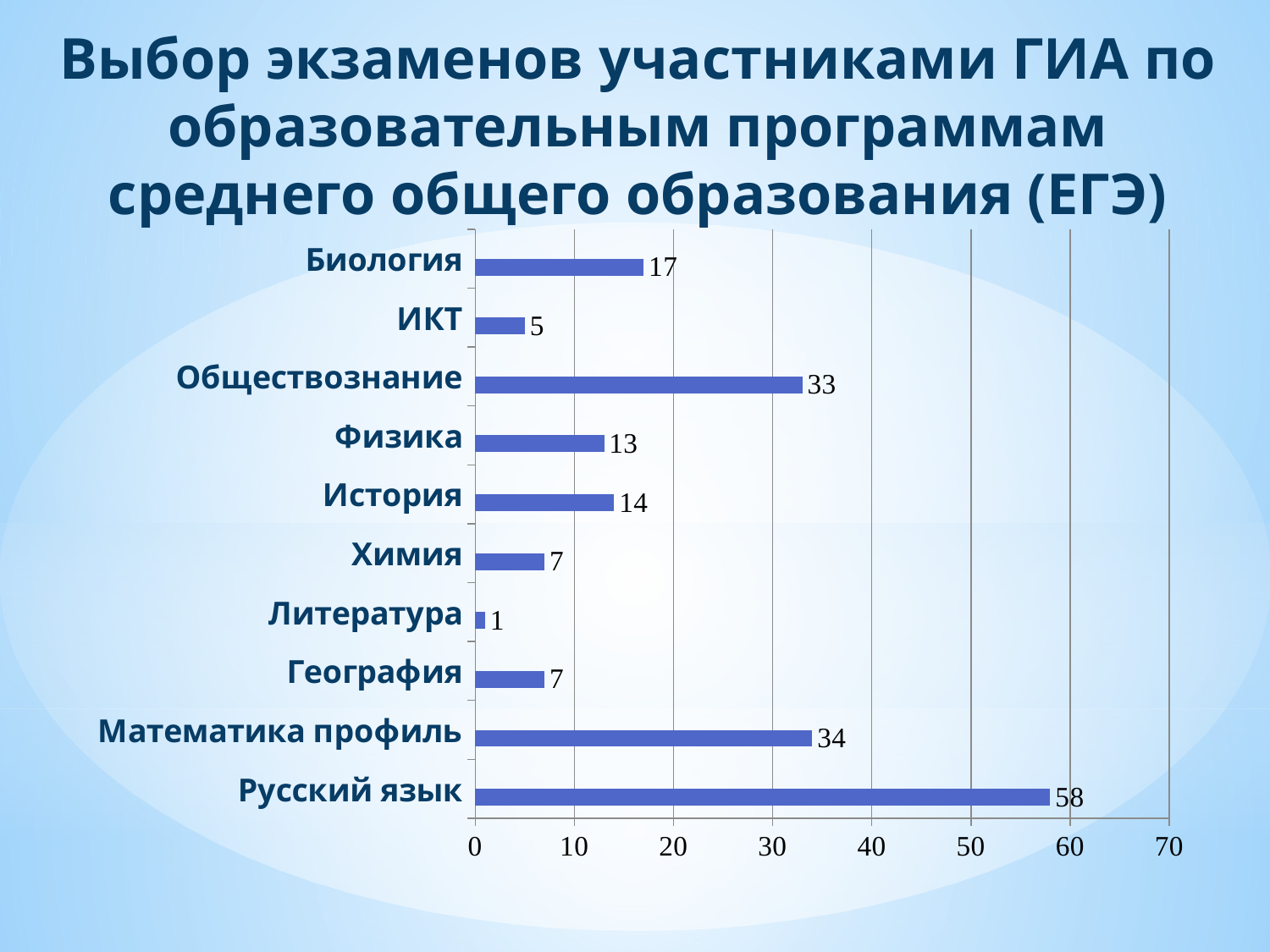
What kind of chart is shown on the slide? bar chart Which category has the lowest value? Литература Which category has the highest value? Русский язык What is the highest value shown on the horizontal axis? 70 How many categories are shown in the chart? 10 What is the value for Русский язык? 58 Which is larger, the value for Биология or the value for История? Биология What is the value for ИКТ? 5 What is the difference between the values for Физика and Химия? 6 What is the value for Обществознание? 33 Is the value for Обществознание greater or less than 30? greater What is the difference between the values for Русский язык and Математика профиль? 24